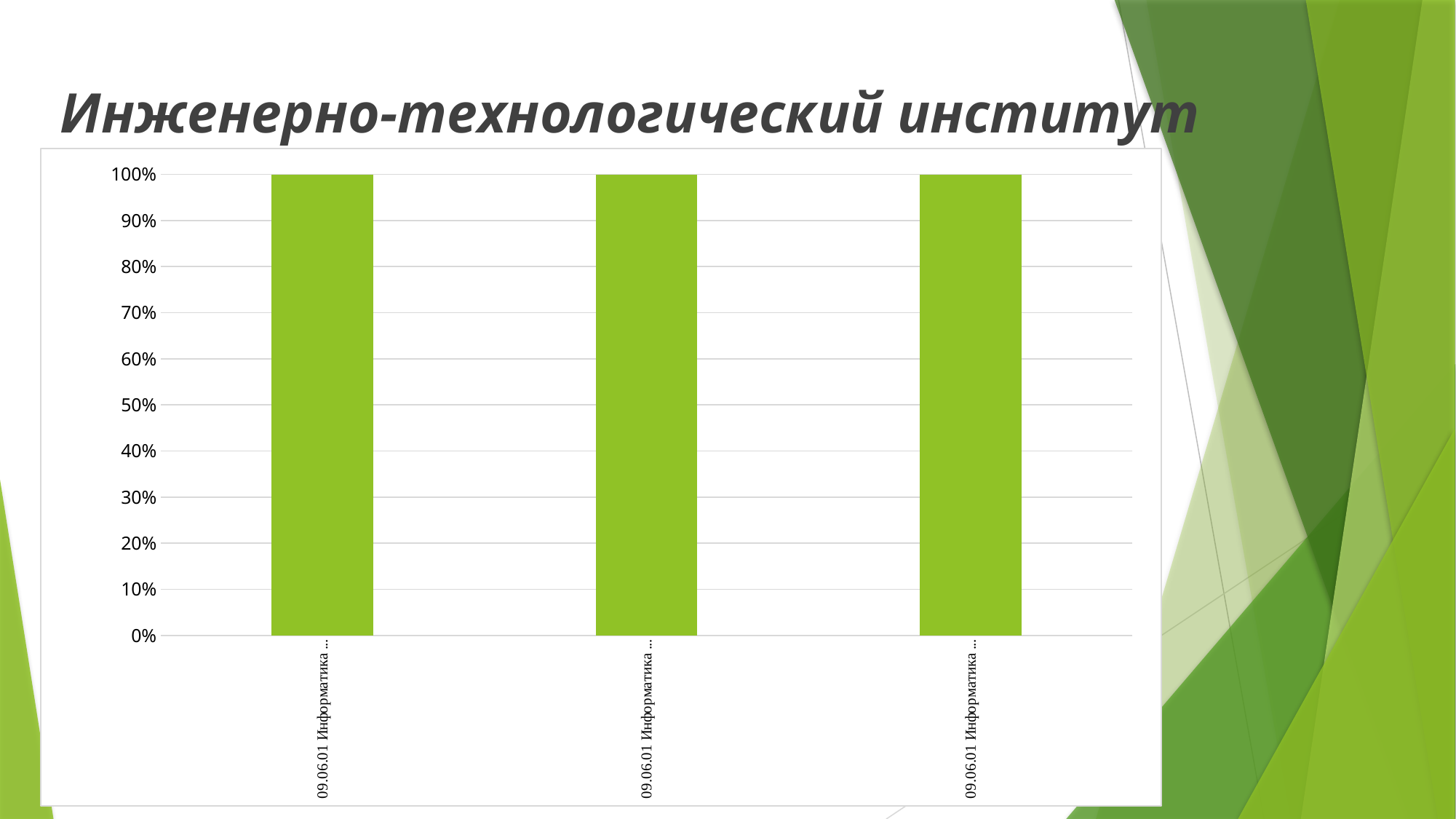
What is the value of the third (rightmost) bar in the chart? 100% What is the difference between the value of the first bar and the value of the second bar? 0% Do the bar values rise, fall, or stay the same from left to right? stay the same What is the highest value shown on the vertical axis? 100% What is the value of the middle bar in the chart? 100% How many bars are plotted in the chart? 3 What kind of chart is shown on the slide? bar chart What colour are the bars in the chart? green Is the value of the rightmost bar greater or less than 90%? greater Is the value of the leftmost bar greater or less than 50%? greater What is the value of the first (leftmost) bar in the chart? 100%